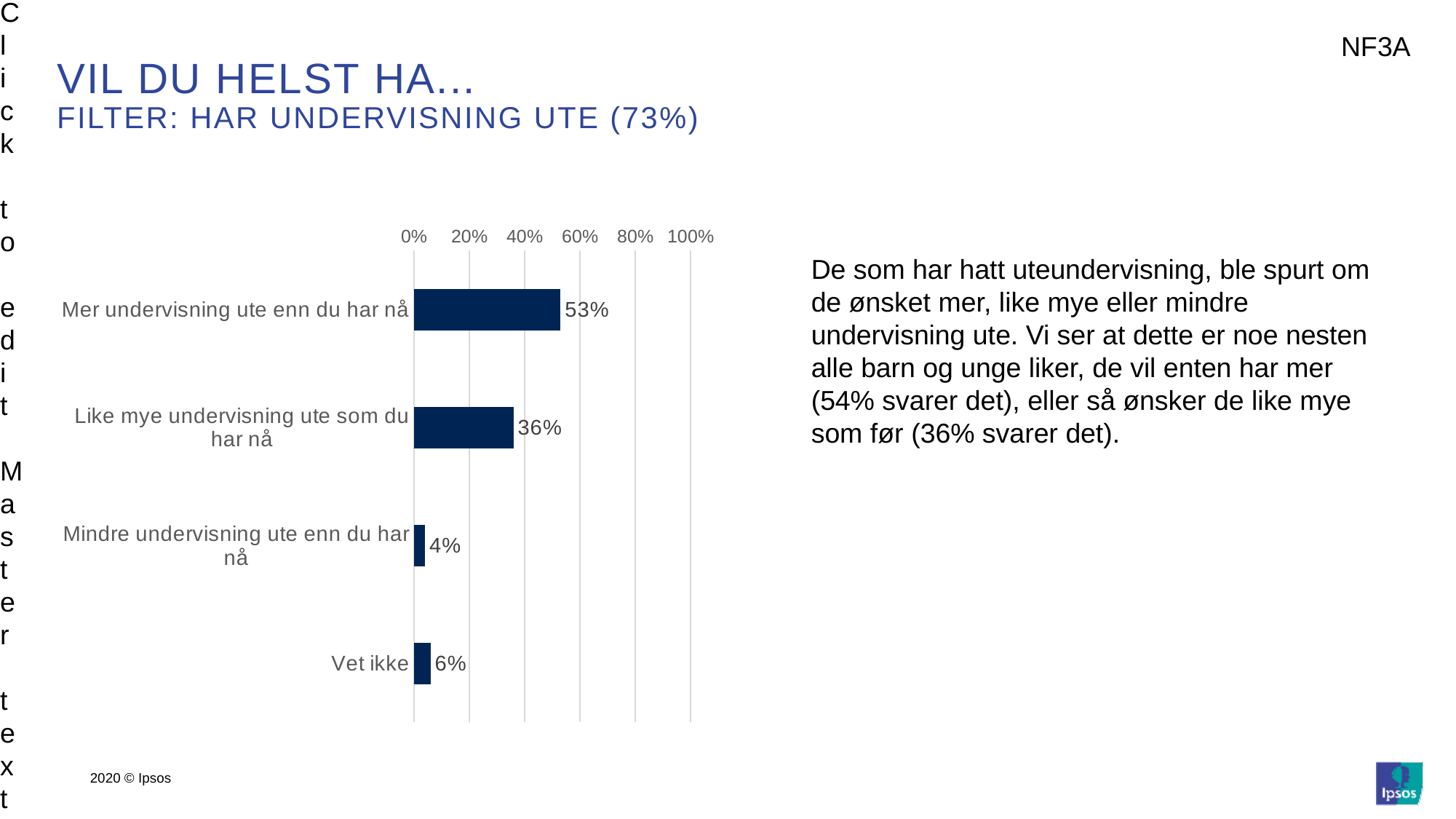
What is the value for "Vet ikke"? 6% What is the value shown for "Like mye undervisning ute som du har nå"? 36% What kind of chart is shown on the slide? Bar chart Which category has the highest value in the chart? Mer undervisning ute enn du har nå What is the maximum value shown on the chart's percentage axis? 100% What percentage of respondents chose "Mer undervisning ute enn du har nå"? 53% What is the difference between the values for "Mer undervisning ute enn du har nå" and "Like mye undervisning ute som du har nå"? 17% Which category has the lowest value in the chart? Mindre undervisning ute enn du har nå What percentage is shown for "Mindre undervisning ute enn du har nå"? 4% Is the value for "Mer undervisning ute enn du har nå" greater or less than 40%? greater How many categories are shown in the chart? 4 Which is larger: the value for "Vet ikke" or the value for "Mindre undervisning ute enn du har nå"? Vet ikke